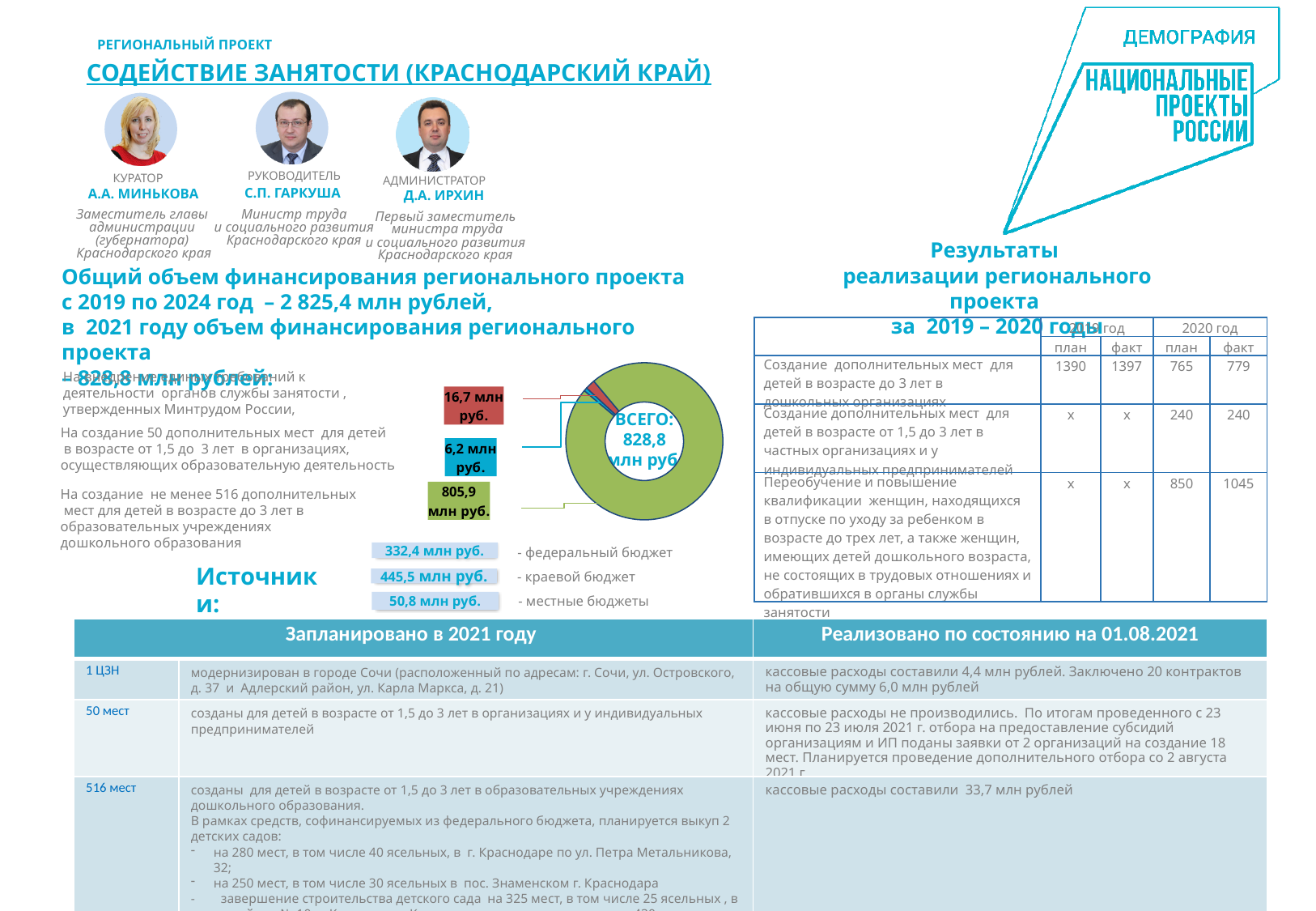
How many segments does the doughnut chart have? 3 Which segment of the doughnut chart has the largest value? 805,9 млн руб. (green) What value is shown for the green segment of the doughnut chart? 805,9 млн руб. Which segment of the doughnut chart has the smallest value? 6,2 млн руб. (blue) What value is shown for the red segment of the doughnut chart? 16,7 млн руб. What value is shown for the blue segment of the doughnut chart? 6,2 млн руб. In the doughnut chart, which is larger: the red segment or the blue segment? The red segment (16,7 млн руб.) What kind of chart is shown in the middle of the slide next to the 'ВСЕГО: 828,8 млн руб' label? Doughnut chart What is the difference between the green segment (805,9 млн руб.) and the red segment (16,7 млн руб.) in the doughnut chart? 789,2 млн руб. What is the difference between the red segment (16,7 млн руб.) and the blue segment (6,2 млн руб.) in the doughnut chart? 10,5 млн руб. What colour is the largest segment of the doughnut chart? Green What total value is printed in the centre of the doughnut chart? 828,8 млн руб